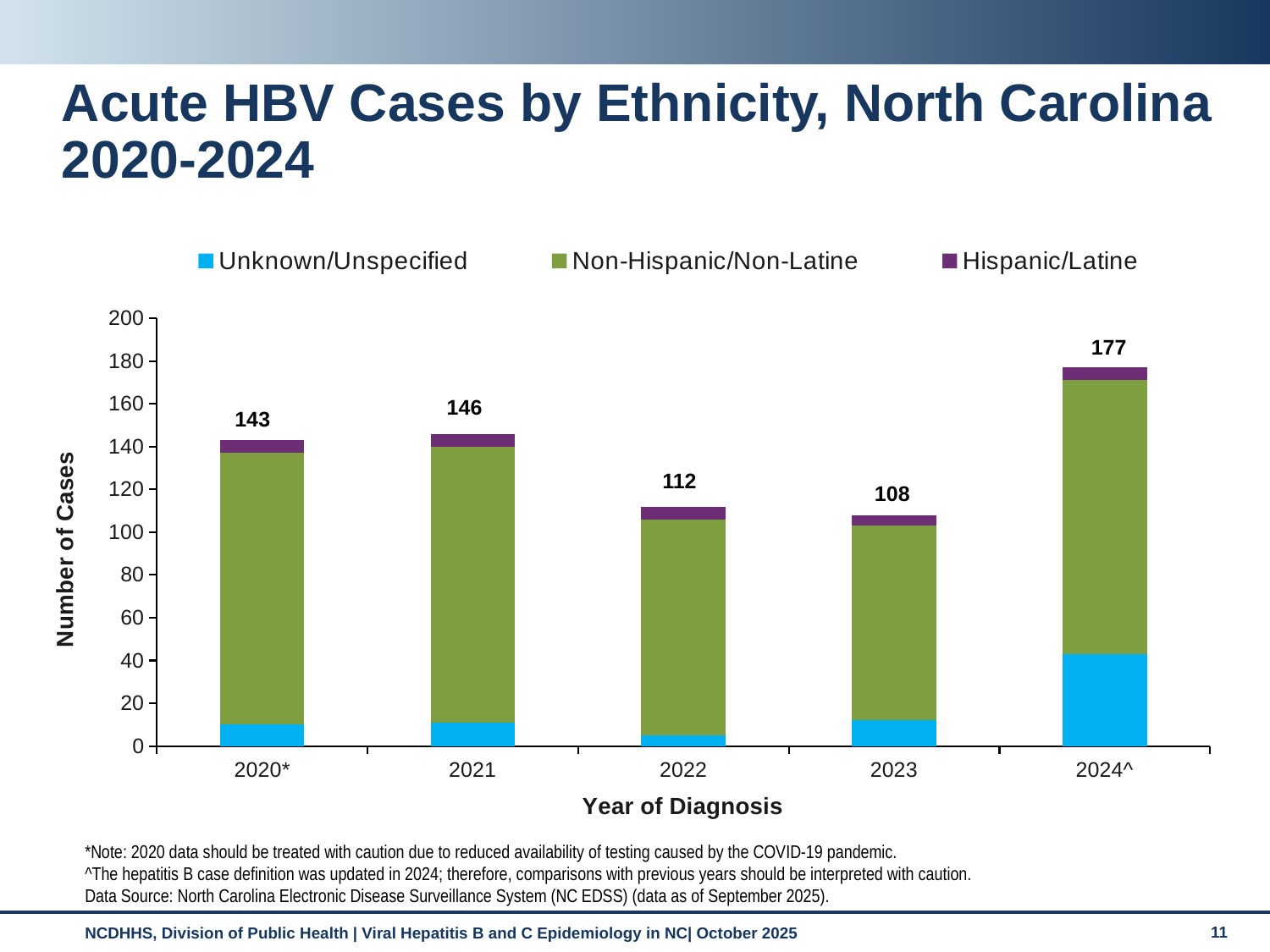
What kind of chart is shown on the slide? Stacked bar chart Which year has the lowest total number of cases? 2023 What is the total number of acute HBV cases in 2024^? 177 What is the total number of acute HBV cases in 2022? 112 Which series is shown in green in the legend? Non-Hispanic/Non-Latine Which year has more total cases, 2022 or 2023? 2022 What is the difference between the total cases in 2021 and 2020*? 3 How many years are shown on the x axis? 5 What is the difference between the total cases in 2024^ and 2023? 69 How many series does the legend list? 3 Is the Unknown/Unspecified value for 2024^ greater or less than 20? greater Which year has the highest total number of cases? 2024^